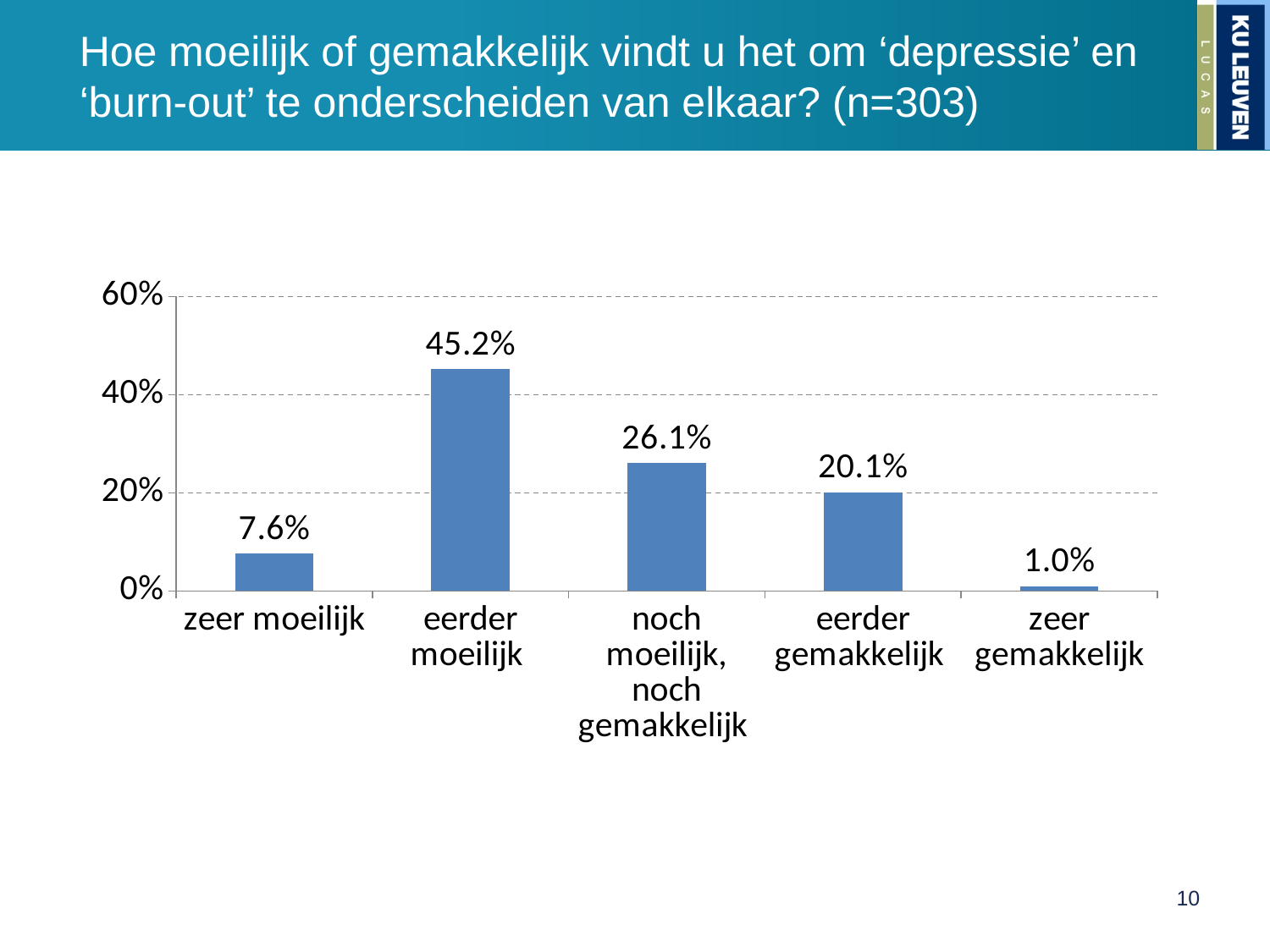
Which category has the lowest value? zeer gemakkelijk What is the value for 'eerder moeilijk'? 45.2% What kind of chart is shown on the slide? bar chart Which category has the highest value? eerder moeilijk What is the difference between the values for 'eerder moeilijk' and 'eerder gemakkelijk'? 25.1% How many categories are shown on the x axis? 5 What is the value for 'noch moeilijk, noch gemakkelijk'? 26.1% What is the value for 'zeer gemakkelijk'? 1.0% What is the highest value shown on the y axis? 60% Which is larger, the value for 'noch moeilijk, noch gemakkelijk' or the value for 'eerder gemakkelijk'? noch moeilijk, noch gemakkelijk Is the value for 'eerder moeilijk' greater or less than 40%? greater What is the value for 'zeer moeilijk'? 7.6%